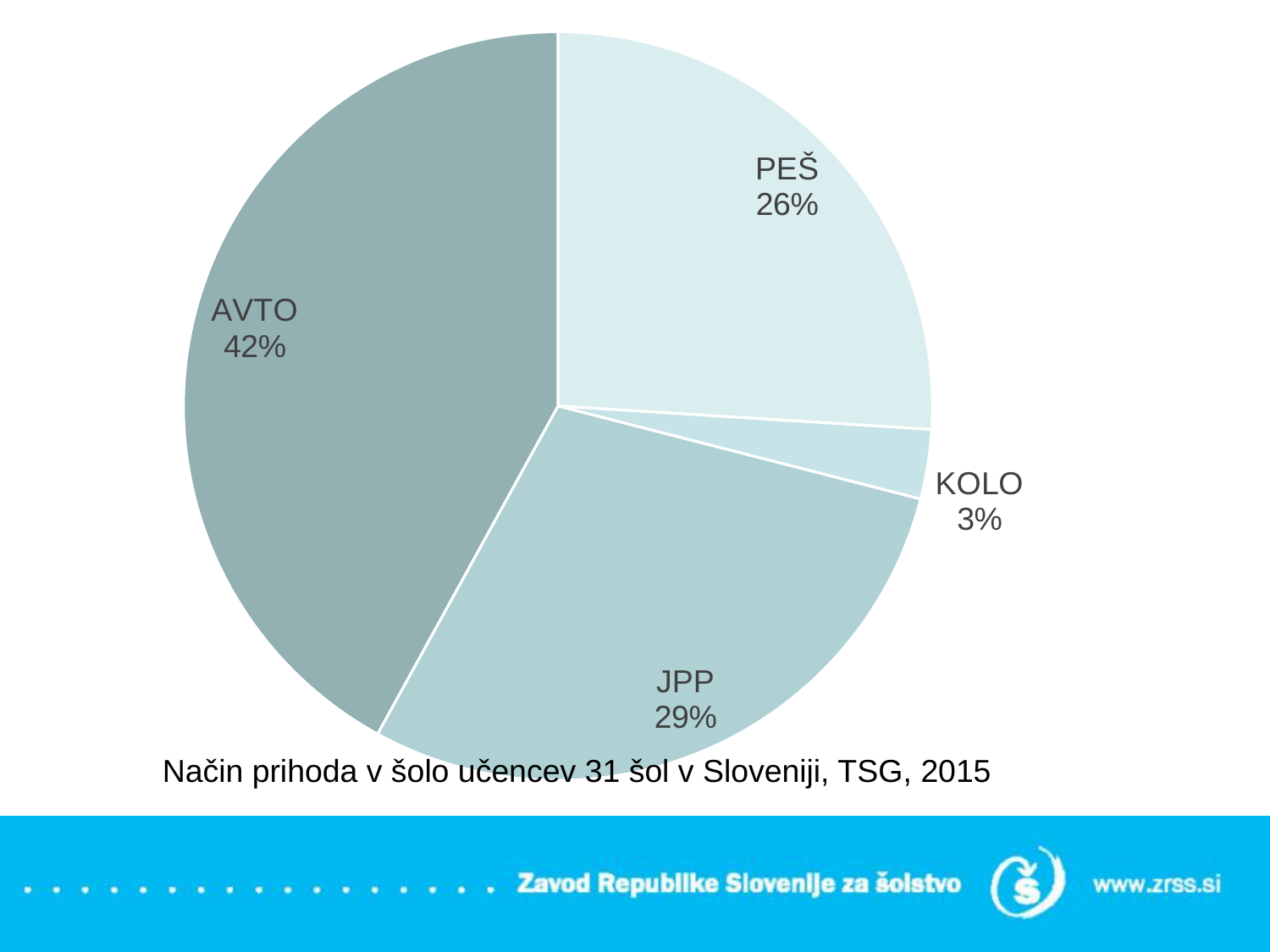
Which category has the smallest slice of the pie? KOLO What is the value shown for KOLO? 3% How many categories are shown in the pie chart? 4 What is the value shown for JPP? 29% What is the difference in percentage points between PEŠ and KOLO? 23 Which is larger, JPP or PEŠ? JPP Which category has the largest slice of the pie? AVTO What is the value shown for PEŠ? 26% What is the difference in percentage points between AVTO and JPP? 13 What share of the pie does AVTO represent? 42% What kind of chart is shown on the slide? Pie chart What is the caption text below the chart? Način prihoda v šolo učencev 31 šol v Sloveniji, TSG, 2015